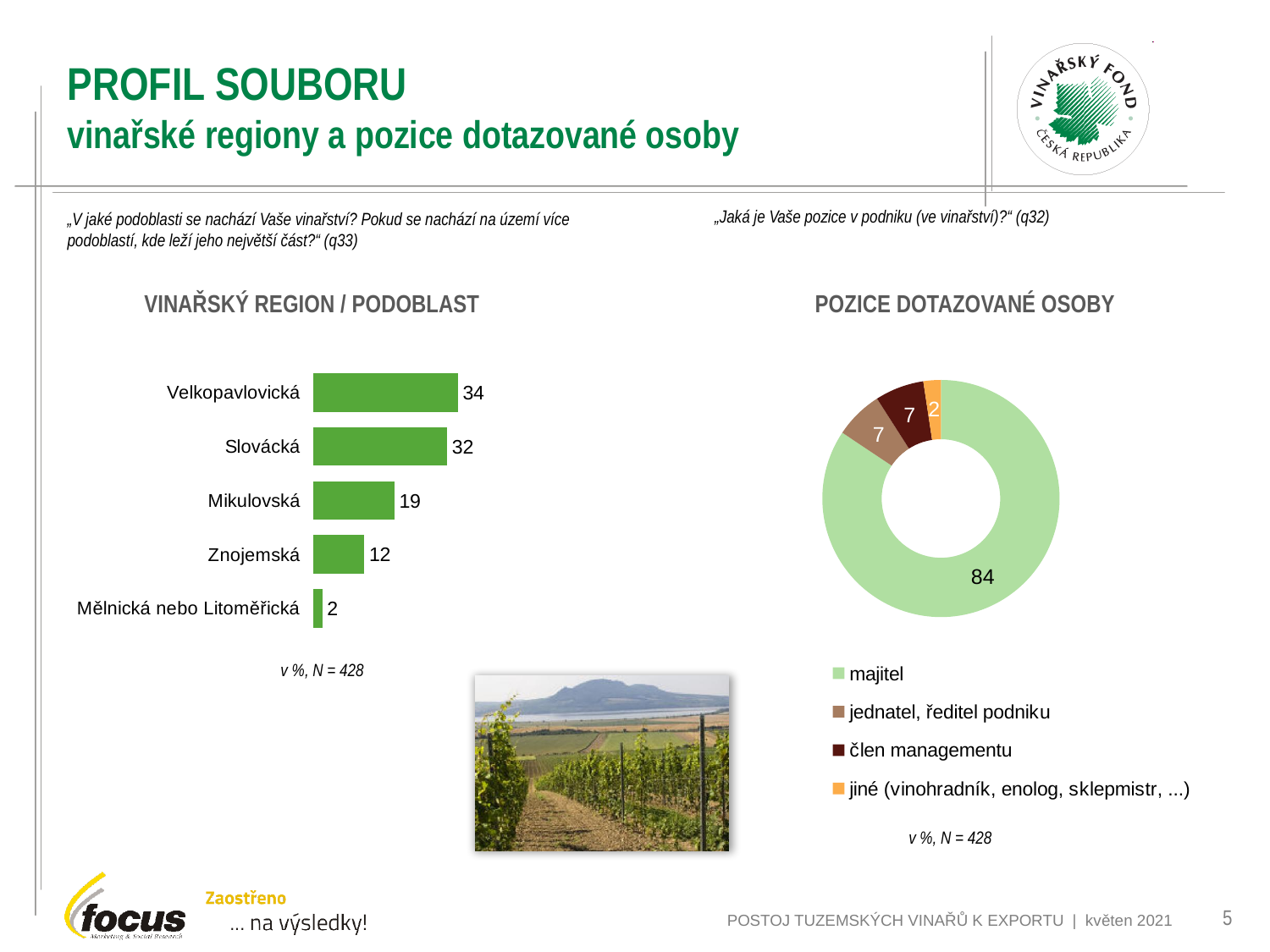
How many regions are shown in the VINAŘSKÝ REGION / PODOBLAST chart? 5 What kind of chart is the VINAŘSKÝ REGION / PODOBLAST chart? bar chart In the VINAŘSKÝ REGION / PODOBLAST chart, which region has the lowest value? Mělnická nebo Litoměřická In the POZICE DOTAZOVANÉ OSOBY chart, what is the value for jiné (vinohradník, enolog, sklepmistr, ...)? 2 How many entries does the legend of the POZICE DOTAZOVANÉ OSOBY chart list? 4 In the VINAŘSKÝ REGION / PODOBLAST chart, what is the value for Velkopavlovická? 34 In the VINAŘSKÝ REGION / PODOBLAST chart, what is the value for Mikulovská? 19 In the VINAŘSKÝ REGION / PODOBLAST chart, which region has the highest value? Velkopavlovická What kind of chart is the POZICE DOTAZOVANÉ OSOBY chart? donut chart In the VINAŘSKÝ REGION / PODOBLAST chart, what is the difference between the values for Slovácká and Znojemská? 20 In the POZICE DOTAZOVANÉ OSOBY chart, what is the value for majitel? 84 In the VINAŘSKÝ REGION / PODOBLAST chart, which is larger, Mikulovská or Znojemská? Mikulovská